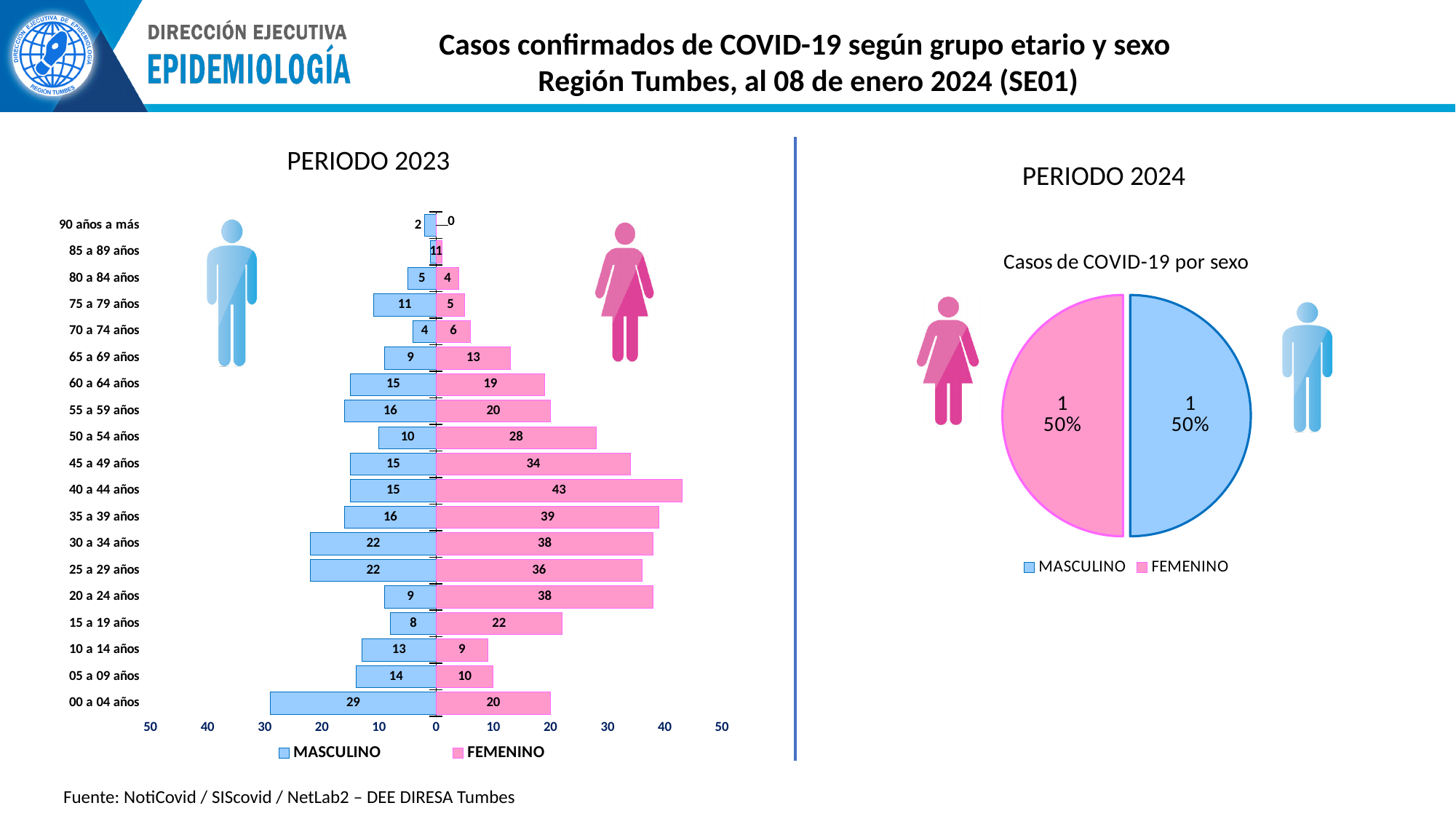
In the PERIODO 2023 chart, which age group has the lowest FEMENINO value? 90 años a más In the PERIODO 2023 chart, which age group has the highest MASCULINO value? 00 a 04 años In the PERIODO 2023 chart, what is the difference between the FEMENINO and MASCULINO values for the 20 a 24 años group? 29 What type of chart is used for PERIODO 2024? Pie chart In the PERIODO 2023 chart, how many FEMENINO cases are shown for the 40 a 44 años group? 43 In the PERIODO 2023 chart, how many MASCULINO cases are shown for the 00 a 04 años group? 29 In the PERIODO 2023 chart, what is the total of MASCULINO and FEMENINO cases for the 30 a 34 años group? 60 In the PERIODO 2023 chart, which age group has the highest FEMENINO value? 40 a 44 años How many age groups are shown in the PERIODO 2023 chart? 19 In the PERIODO 2024 pie chart, what share of cases is FEMENINO? 50% How many series does the legend of the PERIODO 2023 chart list? 2 In the PERIODO 2023 chart, which is larger for the 75 a 79 años group, the MASCULINO or the FEMENINO value? MASCULINO